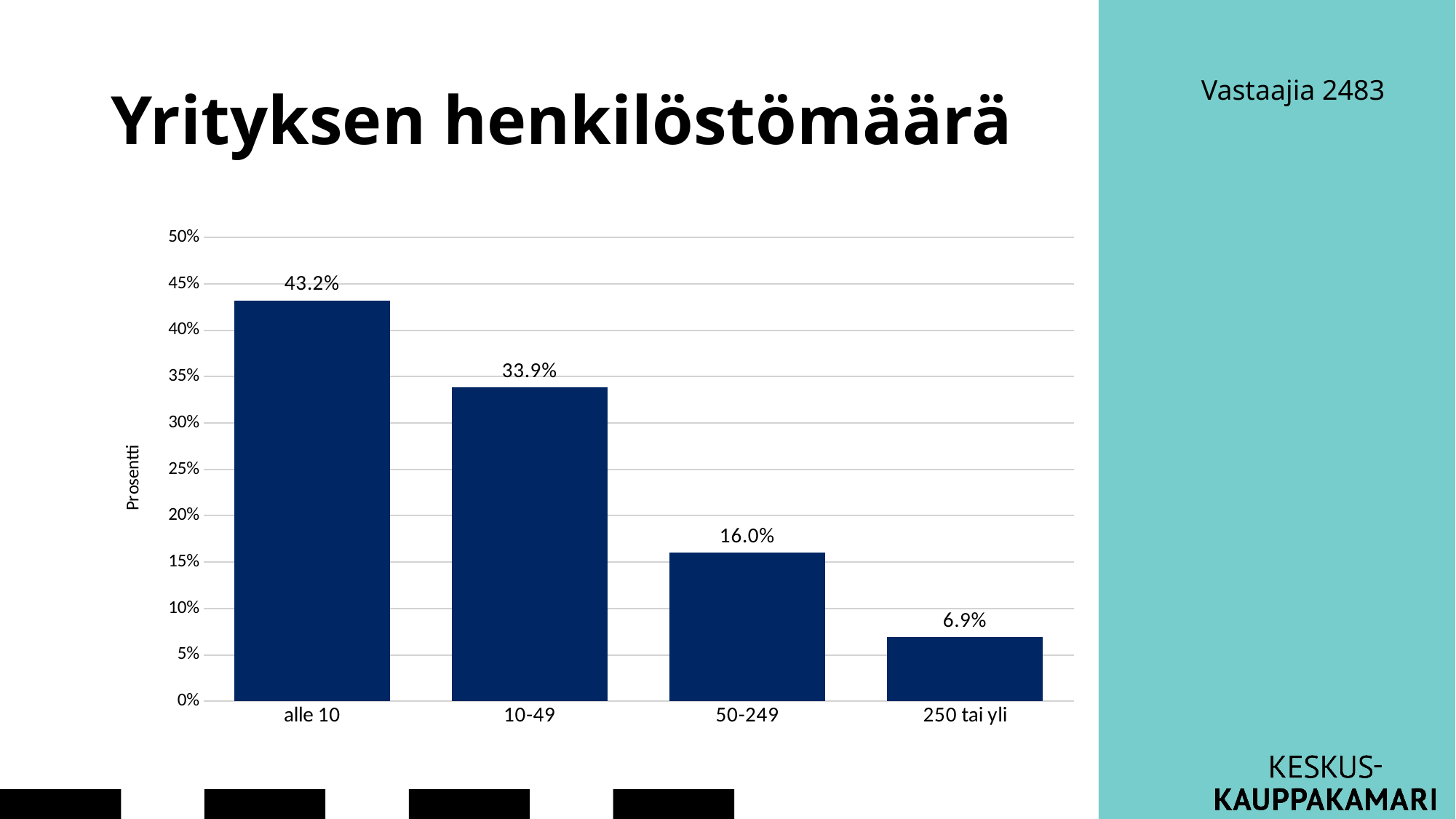
Is the value for '10-49' greater or less than 30%? greater How many categories are shown on the x axis? 4 What is the value for the 'alle 10' category? 43.2% What is the value for the '10-49' category? 33.9% What is the value for the '250 tai yli' category? 6.9% Which category has the highest value? alle 10 What kind of chart is shown on the slide? bar chart What is the value for the '50-249' category? 16.0% What is the difference between the values for 'alle 10' and '10-49'? 9.3% Which is larger, the value for '50-249' or the value for '250 tai yli'? 50-249 Which category has the lowest value? 250 tai yli Do the values rise or fall from left to right along the x axis? fall